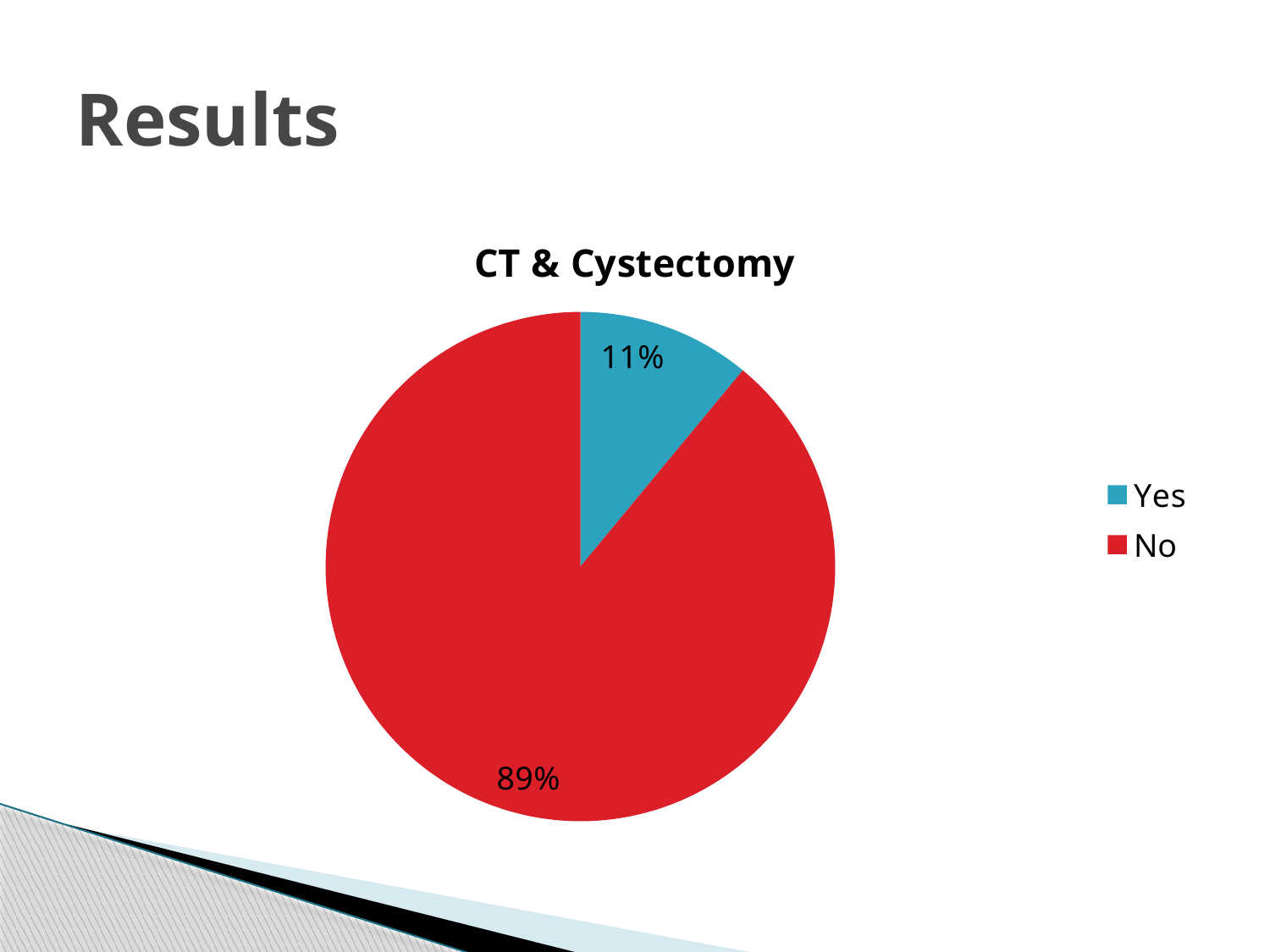
What percentage of the pie is labelled "No"? 89% Which slice is larger, "Yes" or "No"? No What is the difference in percentage points between the "No" and "Yes" slices? 78 Which category has the smallest share of the pie? Yes What percentage of the pie is labelled "Yes"? 11% What colour is the "Yes" slice? blue What is the title of the chart? CT & Cystectomy What share of the pie does the "No" slice represent? 89% How many categories does the legend list? 2 What type of chart is shown on the slide? pie chart Which category has the largest share of the pie? No